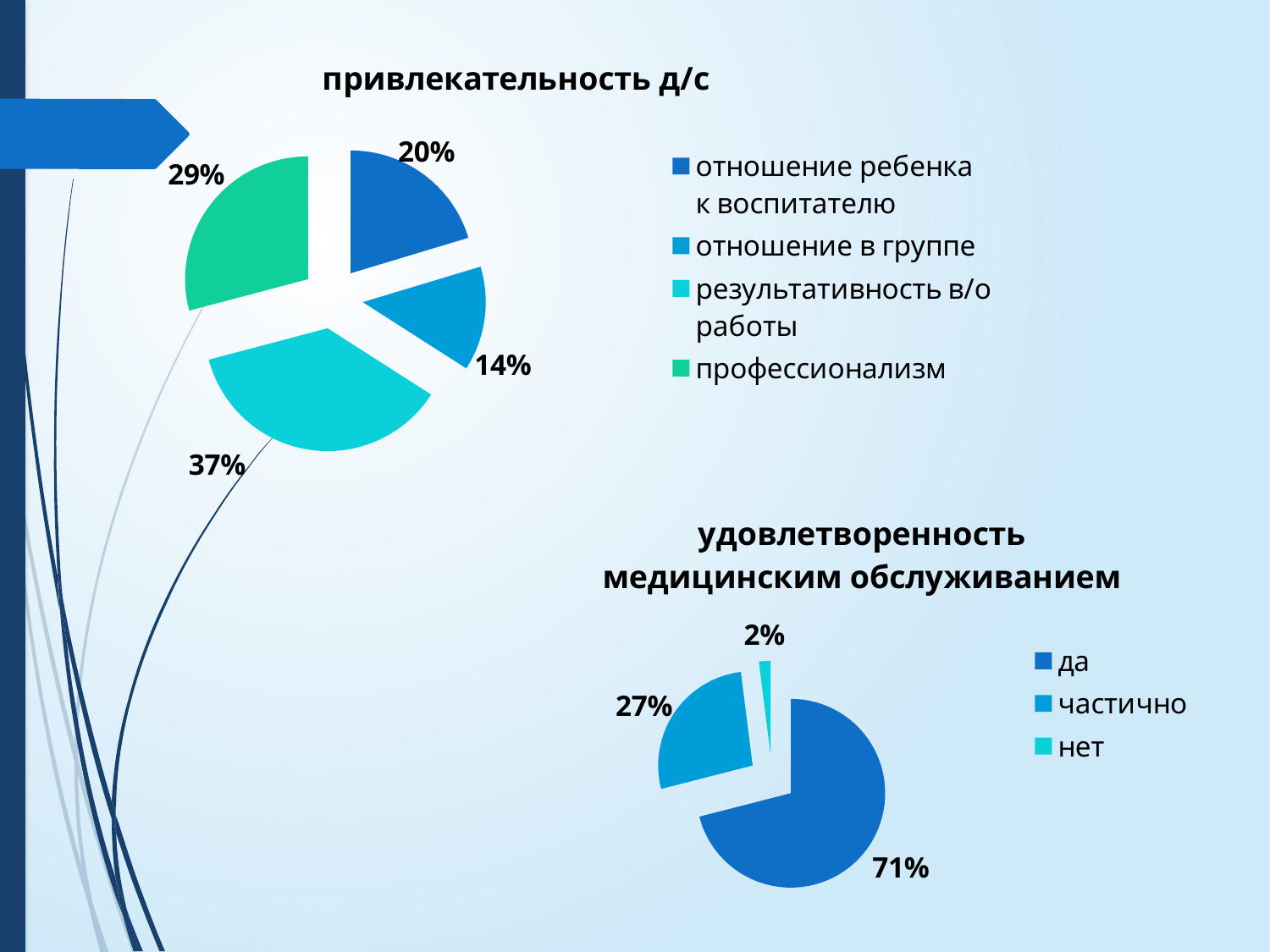
In the chart titled "удовлетворенность медицинским обслуживанием", what share does "да" have? 71% In the chart titled "привлекательность д/с", what share does "результативность в/о работы" have? 37% In the chart titled "удовлетворенность медицинским обслуживанием", what share does "нет" have? 2% In the chart titled "привлекательность д/с", which category has the smallest slice? отношение в группе In the chart titled "удовлетворенность медицинским обслуживанием", what is the difference between "да" and "частично"? 44% In the chart titled "привлекательность д/с", what is the difference between "профессионализм" and "отношение ребенка к воспитателю"? 9% In the chart titled "привлекательность д/с", how many categories does the legend list? 4 In the chart titled "удовлетворенность медицинским обслуживанием", how many categories does the legend list? 3 In the chart titled "удовлетворенность медицинским обслуживанием", which is larger, "частично" or "нет"? частично In the chart titled "привлекательность д/с", which category has the largest slice? результативность в/о работы What kind of chart is the one titled "удовлетворенность медицинским обслуживанием"? pie chart In the chart titled "привлекательность д/с", what share does "отношение в группе" have? 14%